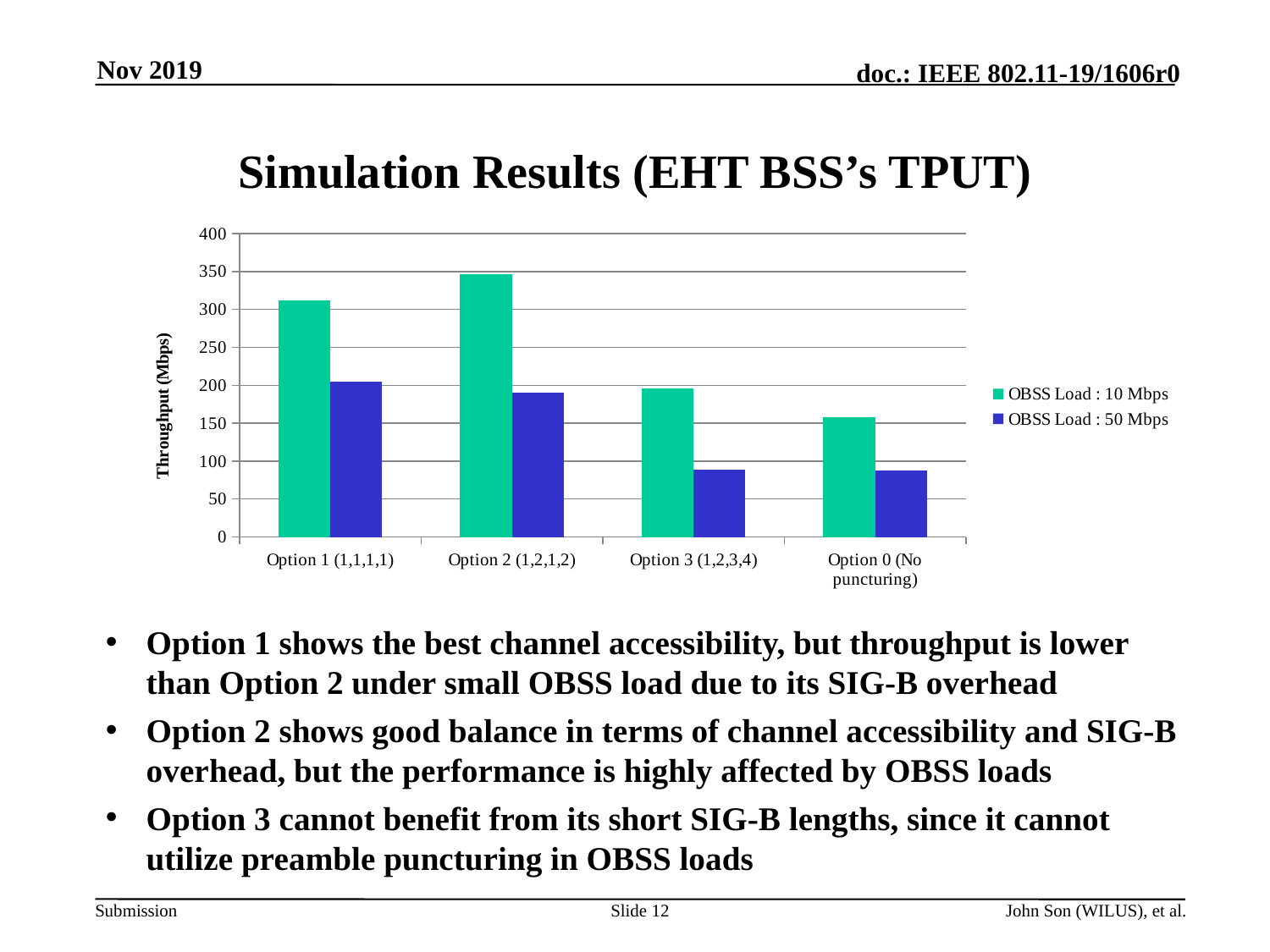
Is the OBSS Load : 50 Mbps throughput for Option 3 (1,2,3,4) greater or less than 100? less Which option has the highest throughput for OBSS Load : 50 Mbps? Option 1 (1,1,1,1) What kind of chart is shown on the slide? bar chart How many series does the legend list? 2 For OBSS Load : 50 Mbps, which is larger: Option 1 (1,1,1,1) or Option 2 (1,2,1,2)? Option 1 (1,1,1,1) Is the OBSS Load : 50 Mbps throughput for Option 2 (1,2,1,2) greater or less than 150? greater What is the label of the y axis? Throughput (Mbps) How many option categories are shown on the x axis? 4 Is the OBSS Load : 10 Mbps throughput for Option 0 (No puncturing) greater or less than 200? less Which option has the highest throughput for OBSS Load : 10 Mbps? Option 2 (1,2,1,2) Which option has the lowest throughput for OBSS Load : 10 Mbps? Option 0 (No puncturing)